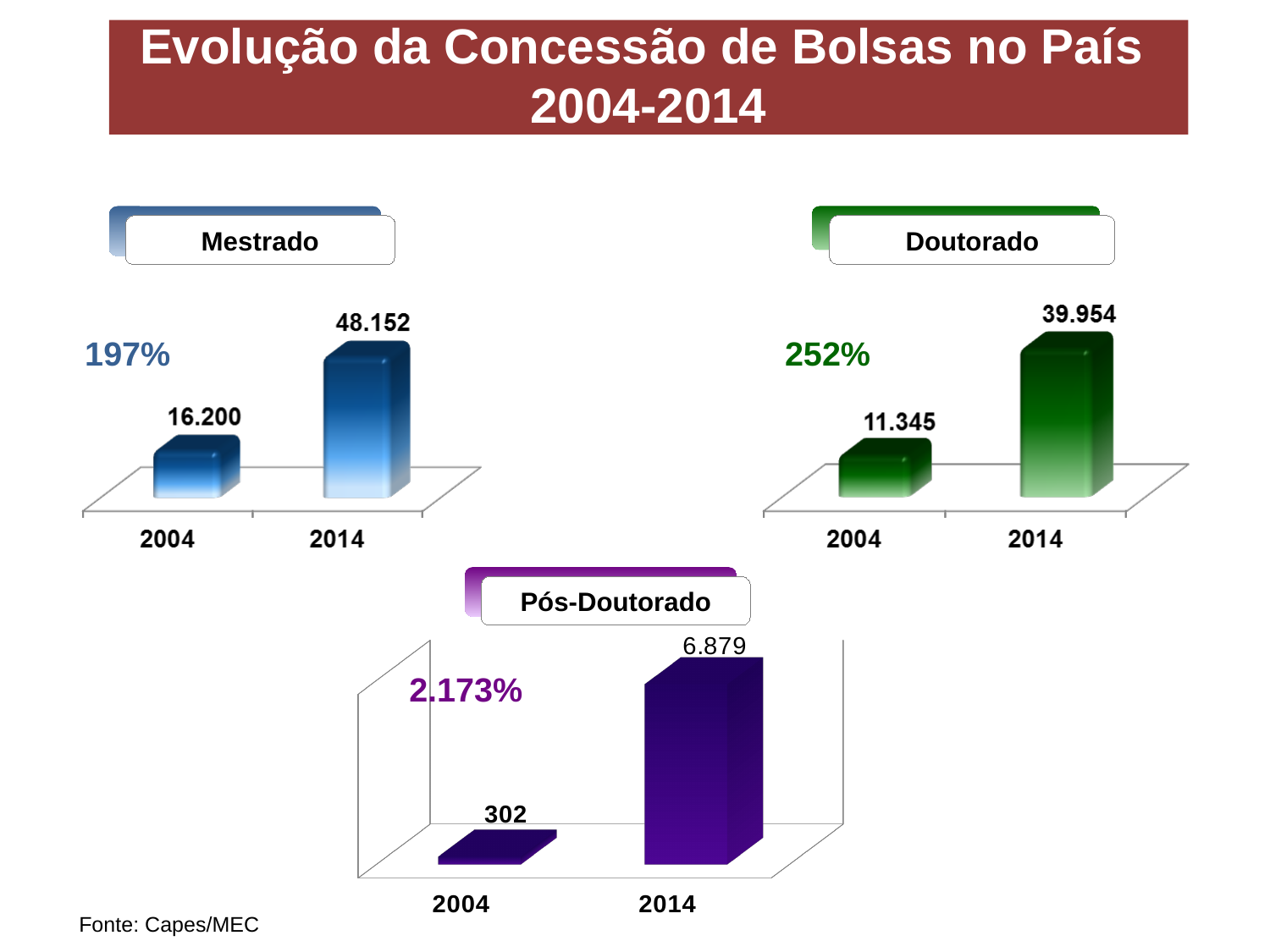
In the Pós-Doutorado chart, what is the value for 2014? 6.879 How many categories are shown on the x axis of the Mestrado chart? 2 In the Doutorado chart, what is the value for 2014? 39.954 In the Mestrado chart, what is the value for 2004? 16.200 In the Doutorado chart, what is the value for 2004? 11.345 What percentage growth is printed on the Pós-Doutorado chart? 2.173% What kind of chart is the Doutorado chart? Bar chart In the Pós-Doutorado chart, what is the value for 2004? 302 In the Mestrado chart, what is the difference between the 2014 and 2004 values? 31.952 In the Doutorado chart, what is the difference between the 2014 and 2004 values? 28.609 In the Mestrado chart, what is the value for 2014? 48.152 In the Pós-Doutorado chart, which year has the higher value, 2004 or 2014? 2014